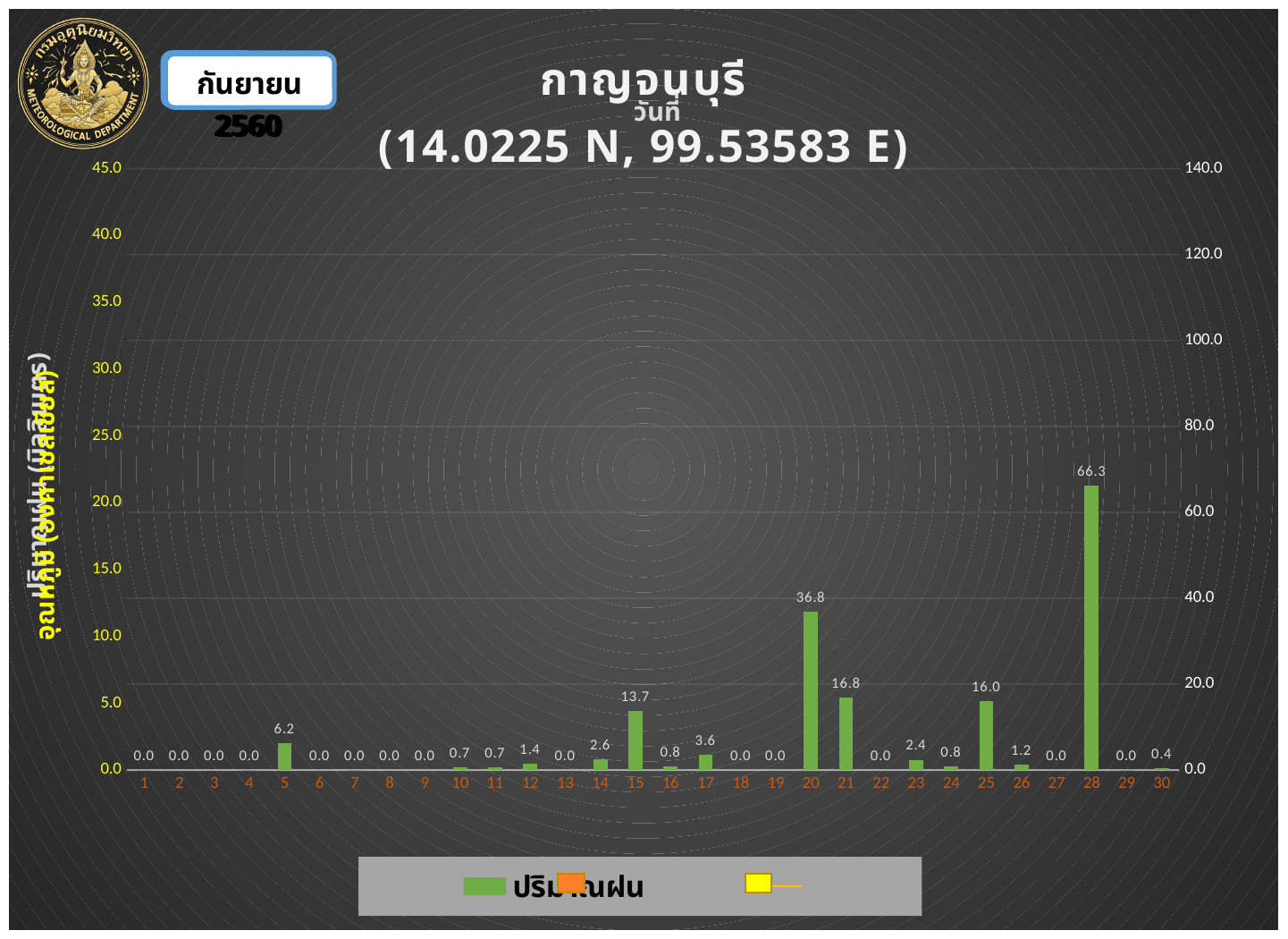
How many days are shown on the x axis? 30 What is the rainfall value shown for day 28? 66.3 What are the coordinates shown in the chart title? 14.0225 N, 99.53583 E What is the rainfall value shown for day 5? 6.2 What is the difference between the rainfall values for day 28 and day 20? 29.5 Is the rainfall value for day 28 greater or less than 60.0 on the right axis? greater What is the difference between the rainfall values for day 21 and day 25? 0.8 Which is larger, the rainfall value for day 15 or for day 21? day 21 Which day has the highest rainfall value? 28 What is the rainfall value shown for day 15? 13.7 What is the rainfall value shown for day 20? 36.8 What kind of chart is shown on the slide? bar chart